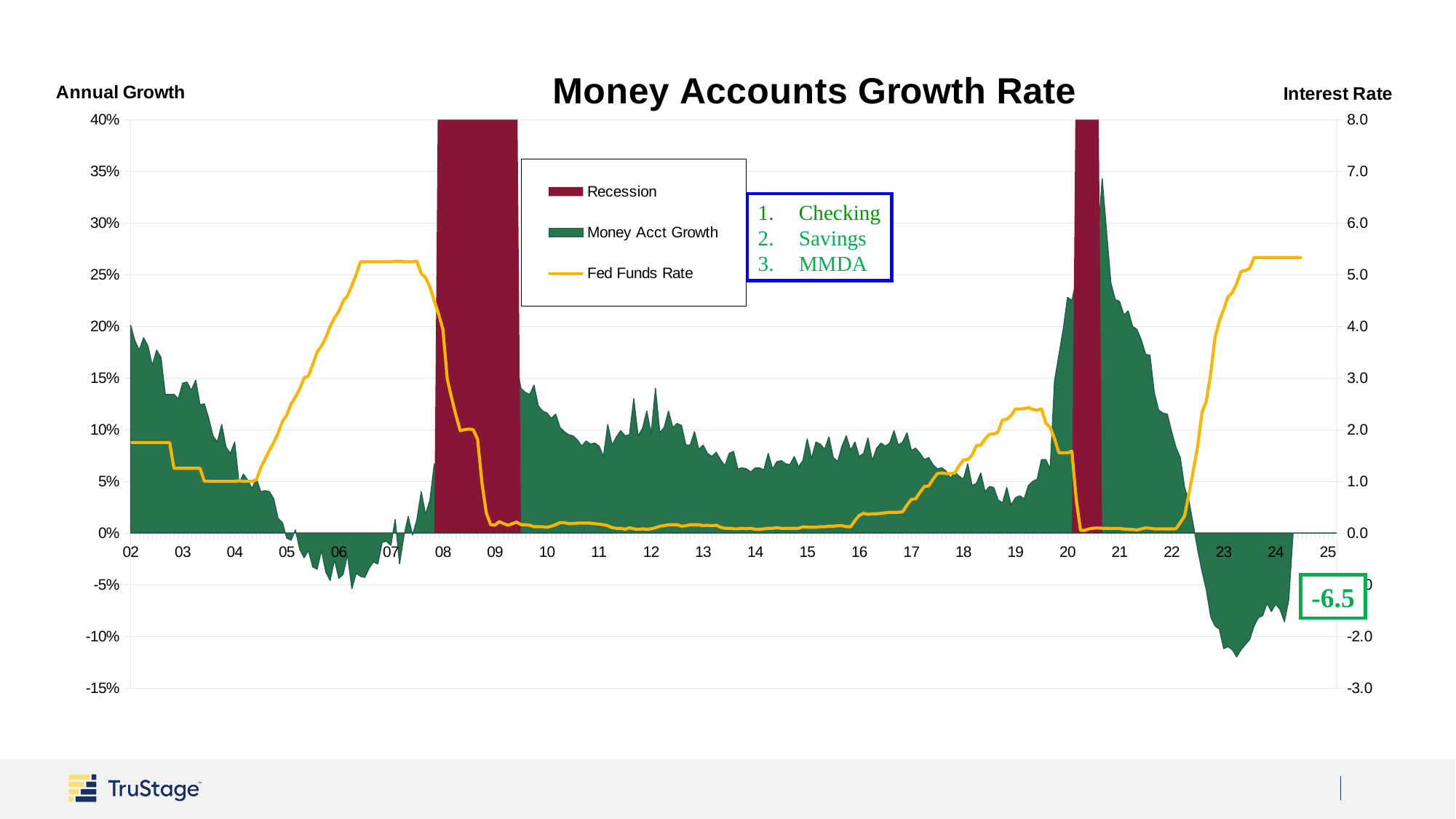
Is the Fed Funds Rate in 2024 greater or less than 5.0? greater Does the Fed Funds Rate rise or fall between 2022 and 2023? rise Which is higher: the peak Money Acct Growth around 2021 or the peak around 2008? around 2021 Is the Fed Funds Rate in 2014 greater or less than 1.0? less Is the peak Money Acct Growth value around 2021 greater or less than 30%? greater What is the title of the chart? Money Accounts Growth Rate What colour is used for the Recession series in the chart? dark red How many series does the chart legend list? 3 How many recession bands are shaded on the chart? 2 What value is annotated in the green box at the end of the Money Acct Growth series? -6.5 What kind of chart is used to plot the Fed Funds Rate series? line chart